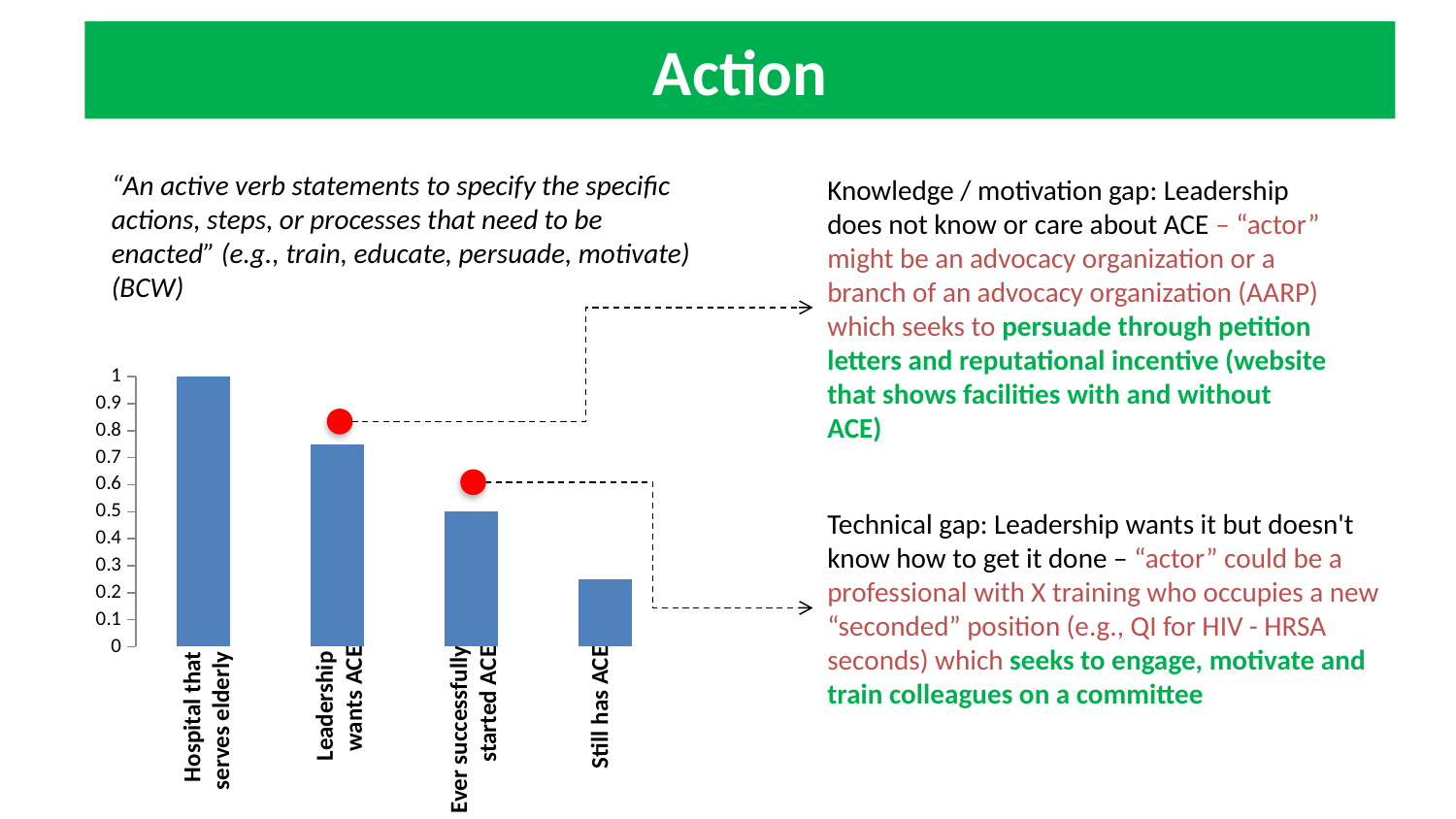
What is the highest value shown on the vertical axis? 1 What is the difference between the values for "Hospital that serves elderly" and "Ever successfully started ACE"? 0.5 How many categories are shown on the chart? 4 What is the value for "Ever successfully started ACE"? 0.5 What kind of chart is shown on the slide? bar chart Which is larger, the value for "Leadership wants ACE" or the value for "Still has ACE"? Leadership wants ACE What is the value for "Hospital that serves elderly"? 1 Do the values rise or fall from left to right along the x axis? fall Which category has the lowest value? Still has ACE Which category has the highest value? Hospital that serves elderly Is the value for "Leadership wants ACE" greater or less than 0.7? greater Is the value for "Still has ACE" greater or less than 0.3? less